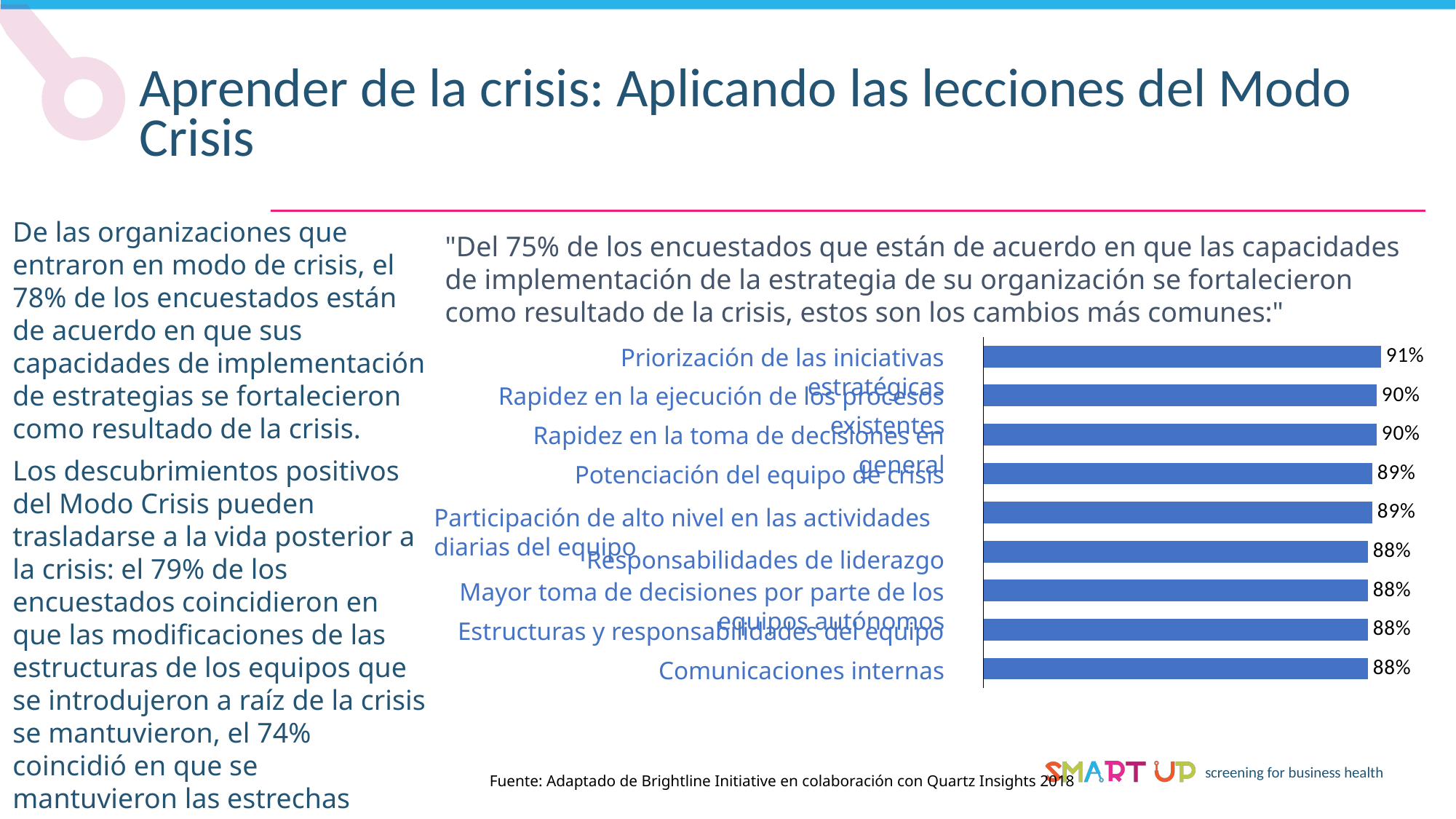
What type of chart is shown on the slide? Bar chart Which category has the highest value in the chart? Priorización de las iniciativas estratégicas Which is larger, the value for "Rapidez en la ejecución de los procesos existentes" or the value for "Estructuras y responsabilidades del equipo"? Rapidez en la ejecución de los procesos existentes What is the value for "Responsabilidades de liderazgo"? 88% What is the lowest value shown in the chart? 88% What is the value for "Comunicaciones internas"? 88% What is the difference between the values for "Priorización de las iniciativas estratégicas" and "Comunicaciones internas"? 3 percentage points How many categories are plotted in the bar chart? 9 What is the value for "Rapidez en la toma de decisiones en general"? 90% What is the value for "Priorización de las iniciativas estratégicas"? 91% What is the value for "Potenciación del equipo de crisis"? 89% What colour are the bars in the chart? Blue